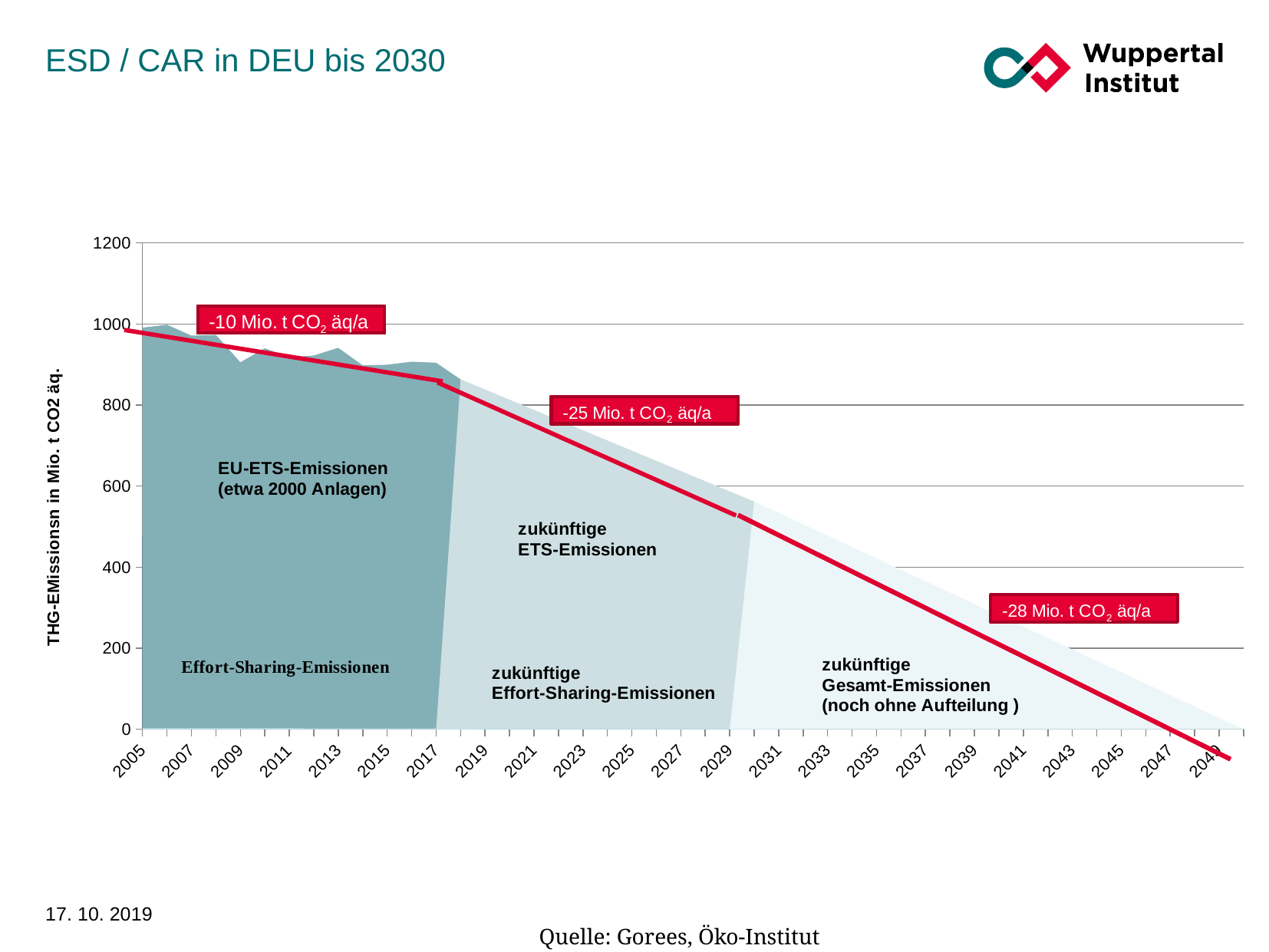
Is the emissions value for 2005 greater or less than 800? greater Do the emissions values rise or fall along the x axis from 2005 to 2049? fall What annual reduction rate is shown in the red box for the period between 2017 and 2029? -25 Mio. t CO2 äq/a Is the emissions value for 2045 greater or less than 200? less What kind of chart is shown on the slide? area chart Is the emissions value for 2023 greater or less than 600? greater What annual reduction rate is shown in the red box for the period up to 2017? -10 Mio. t CO2 äq/a What is the label of the y axis? THG-EMissionsn in Mio. t CO2 äq. What is the title of the slide containing the chart? ESD / CAR in DEU bis 2030 What annual reduction rate is shown in the red box for the period after 2029? -28 Mio. t CO2 äq/a